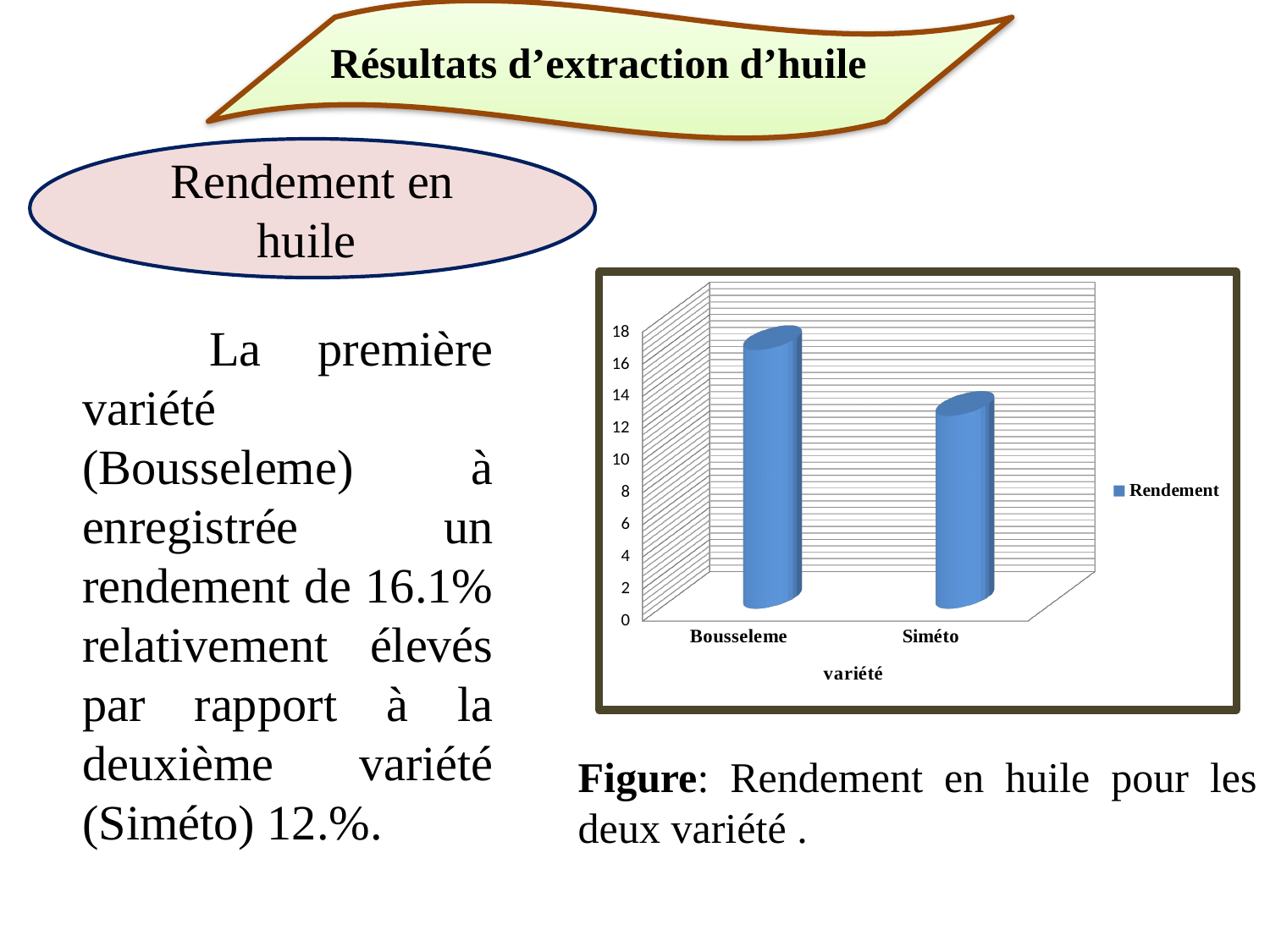
What is the name of the series listed in the chart legend? Rendement How many series does the chart legend list? 1 Which variety has the lowest bar in the chart? Siméto What kind of chart is shown on the slide? bar chart What is the label of the x axis of the chart? variété Which bar is taller, Bousseleme or Siméto? Bousseleme Do the bar values rise or fall from Bousseleme to Siméto along the x axis? fall Which variety has the highest bar in the chart? Bousseleme Is the value for Siméto greater or less than 10? greater Is the value for Siméto greater or less than 14? less How many categories are shown on the x axis of the chart? 2 Is the value for Bousseleme greater or less than 14? greater